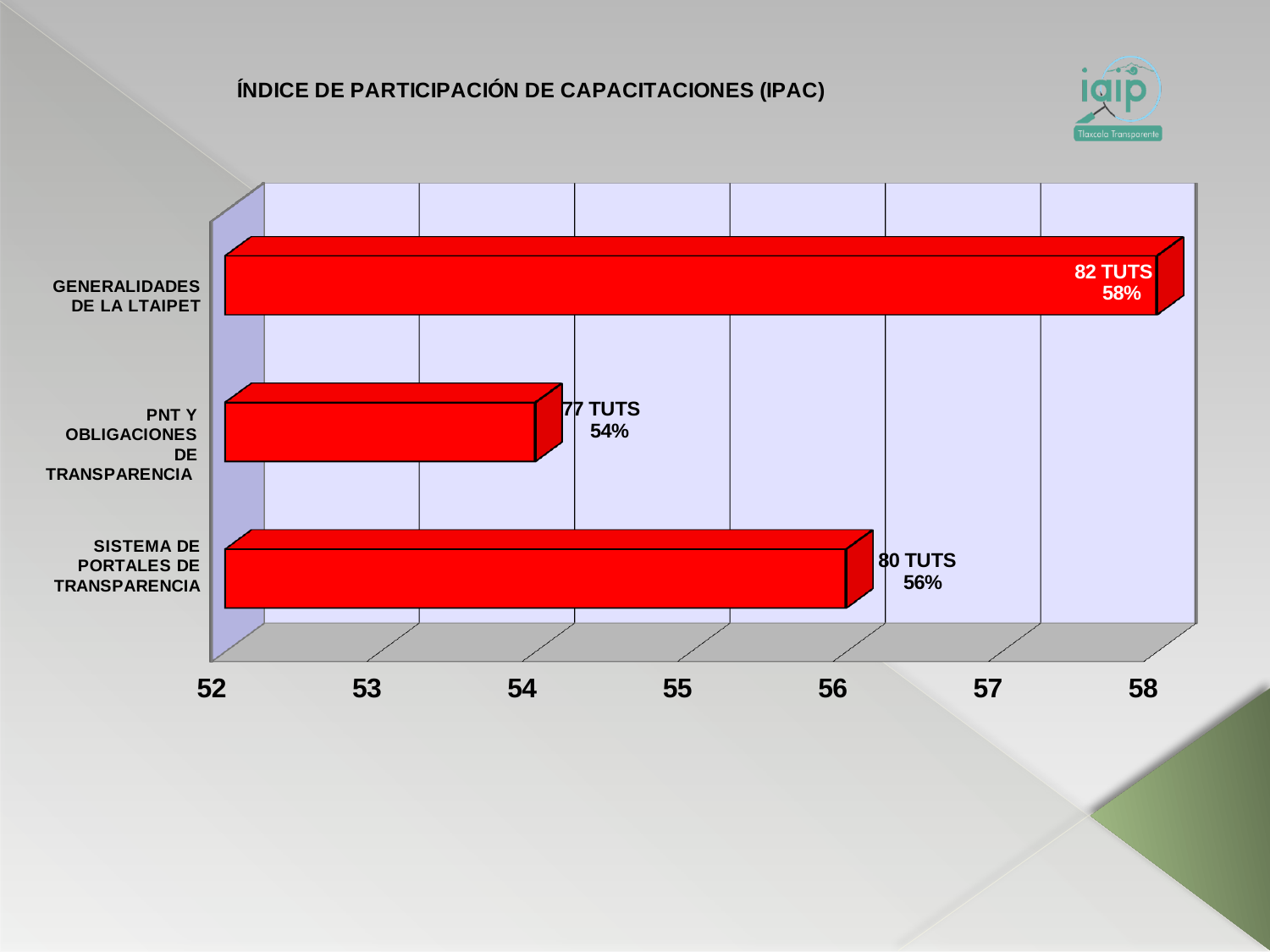
How many TUTS are shown for GENERALIDADES DE LA LTAIPET? 82 TUTS Is the value for GENERALIDADES DE LA LTAIPET greater or less than 57? greater What percentage is shown for SISTEMA DE PORTALES DE TRANSPARENCIA? 56% What kind of chart is shown on the slide? bar chart Which category has the highest value? GENERALIDADES DE LA LTAIPET What percentage is shown for GENERALIDADES DE LA LTAIPET? 58% How many categories are plotted in the chart? 3 Which is larger, the value for SISTEMA DE PORTALES DE TRANSPARENCIA or the value for PNT Y OBLIGACIONES DE TRANSPARENCIA? SISTEMA DE PORTALES DE TRANSPARENCIA What is the difference in TUTS between GENERALIDADES DE LA LTAIPET and PNT Y OBLIGACIONES DE TRANSPARENCIA? 5 TUTS What is the title of the chart? ÍNDICE DE PARTICIPACIÓN DE CAPACITACIONES (IPAC) How many TUTS are shown for PNT Y OBLIGACIONES DE TRANSPARENCIA? 77 TUTS Which category has the lowest value? PNT Y OBLIGACIONES DE TRANSPARENCIA